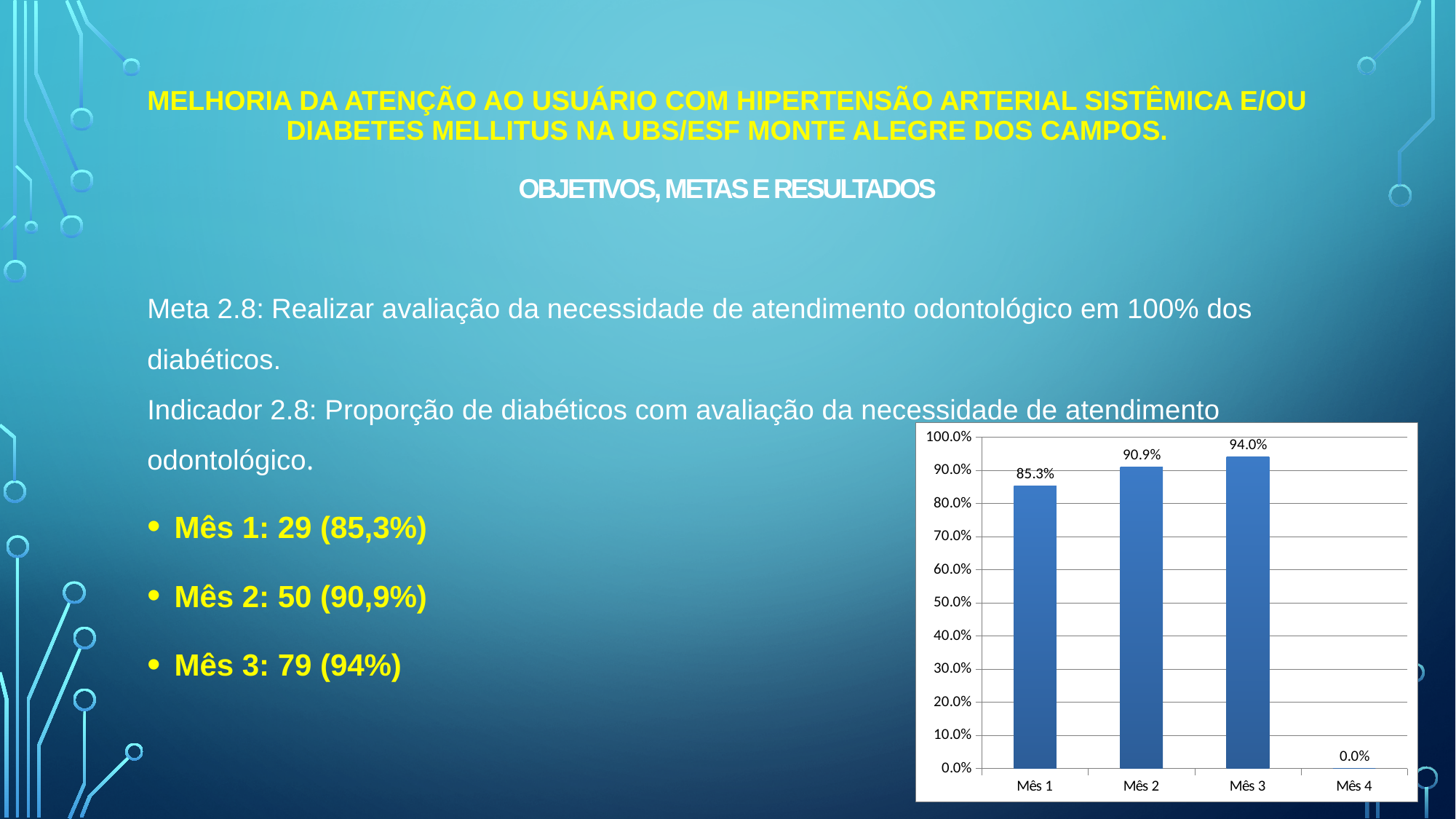
How many categories are shown on the x axis of the chart? 4 Which month has the highest value in the chart? Mês 3 Is the value for Mês 1 greater or less than 80.0%? greater Which month has the lowest value in the chart? Mês 4 Do the values rise or fall from Mês 1 to Mês 3? rise What is the value for Mês 3 in the chart? 94.0% What is the difference between the values for Mês 3 and Mês 1? 8.7% What is the value for Mês 4 in the chart? 0.0% What is the value for Mês 2 in the chart? 90.9% What kind of chart is shown on the slide? bar chart Which is larger, the value for Mês 2 or the value for Mês 1? Mês 2 What is the value for Mês 1 in the chart? 85.3%